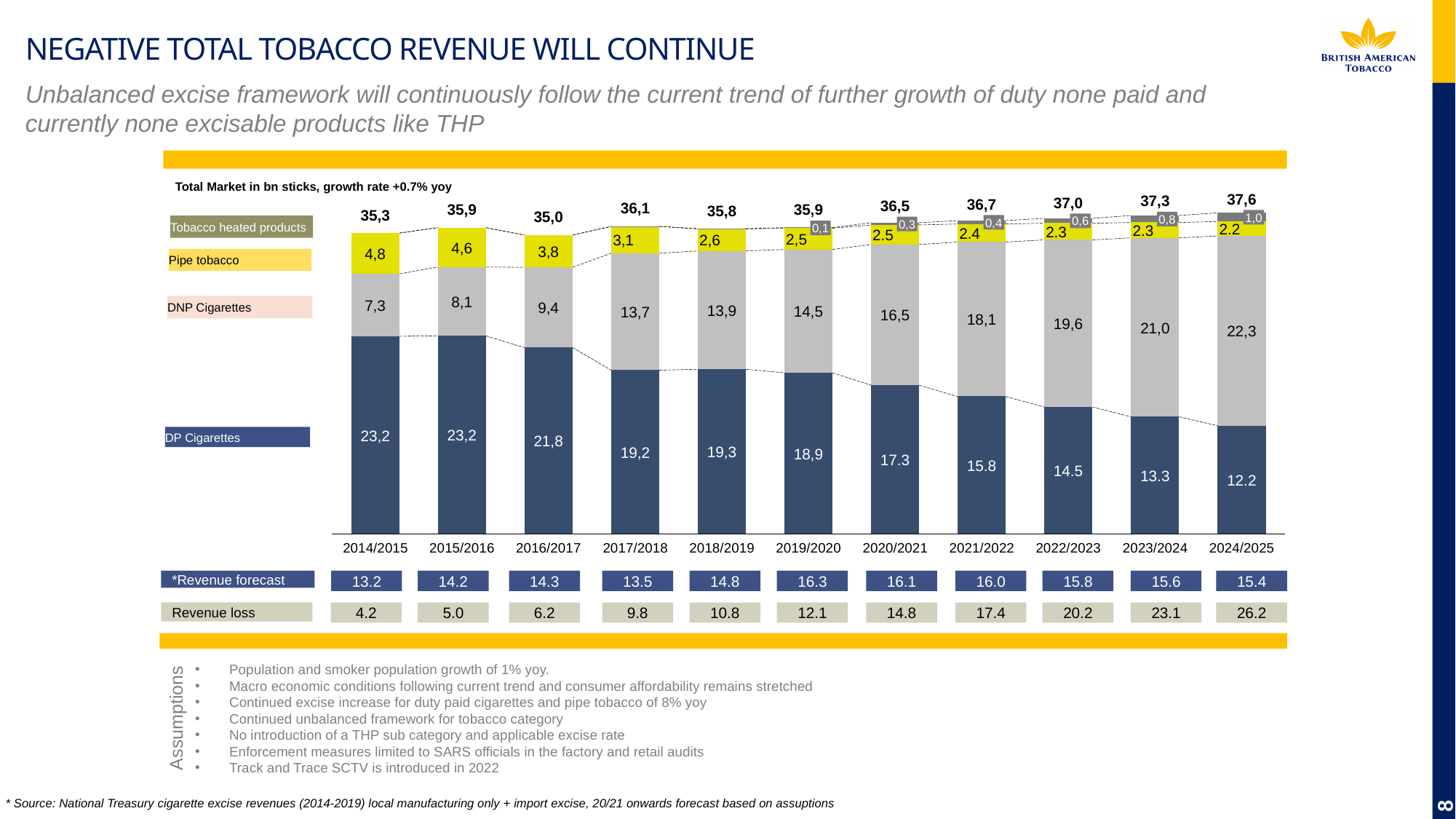
In 2019/2020, which is larger: DP Cigarettes or DNP Cigarettes? DP Cigarettes Which year has the highest total market value? 2024/2025 What is the value for DP Cigarettes in 2014/2015? 23,2 Which year has the lowest total market value? 2016/2017 What is the total market (bn sticks) shown above the bar for 2020/2021? 36,5 How many years are shown on the x axis of the chart? 11 What is the value for Tobacco heated products in 2021/2022? 0,4 By how much did DNP Cigarettes increase from 2016/2017 to 2017/2018? 4,3 How many series does the chart legend list? 4 Do the DP Cigarettes values rise or fall from 2014/2015 to 2024/2025? fall What is the value for DNP Cigarettes in 2024/2025? 22,3 What is the value for Pipe tobacco in 2016/2017? 3,8